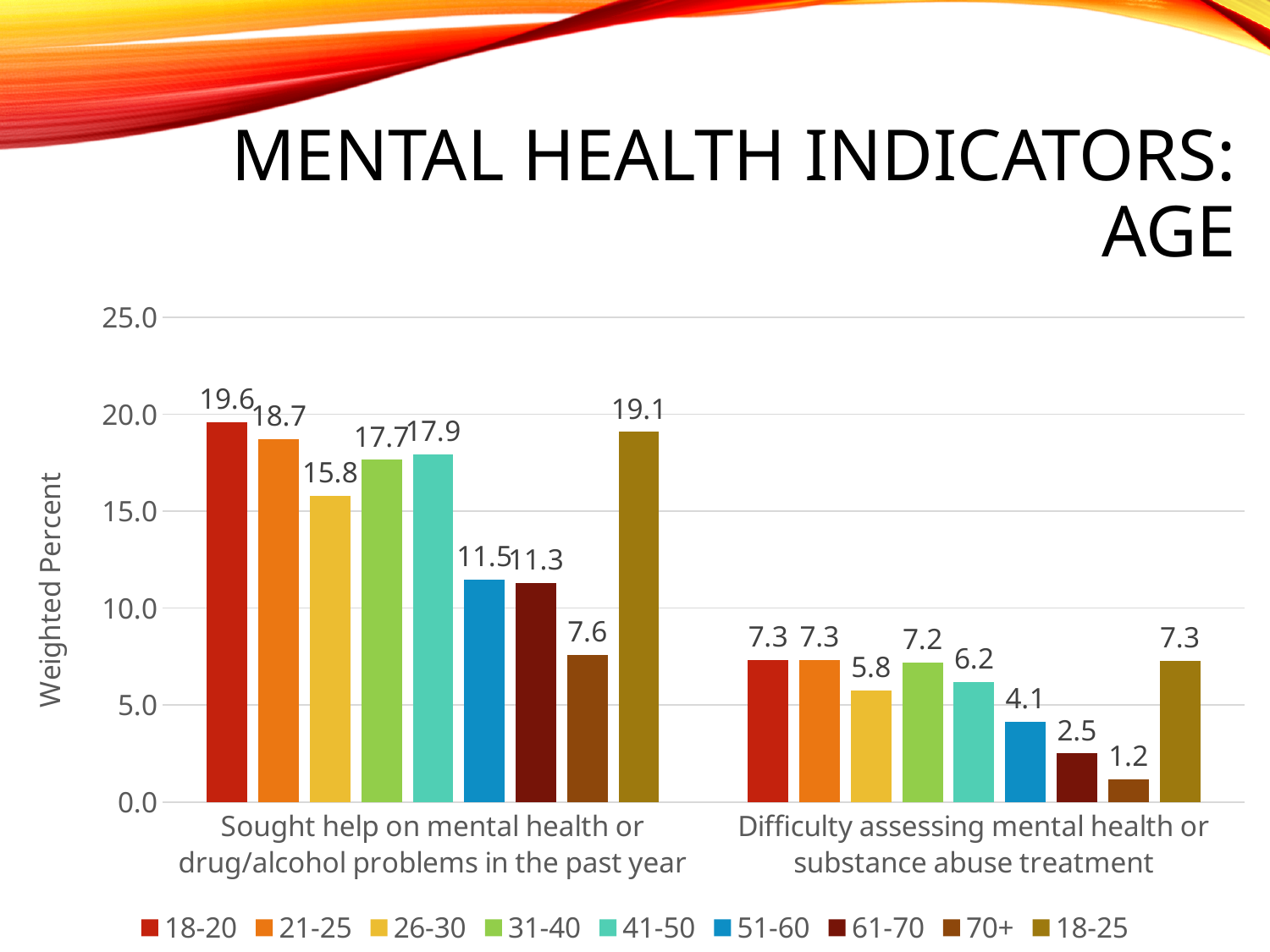
What is the value for the 51-60 age group for "Sought help on mental health or drug/alcohol problems in the past year"? 11.5 What is the label on the y axis? Weighted Percent What is the value for the 18-20 age group for "Sought help on mental health or drug/alcohol problems in the past year"? 19.6 For "Sought help on mental health or drug/alcohol problems in the past year", which is larger: the value for 26-30 or the value for 31-40? 31-40 What is the value for the 70+ age group for "Difficulty assessing mental health or substance abuse treatment"? 1.2 How many categories are shown on the x axis? 2 Which age group has the lowest value for "Difficulty assessing mental health or substance abuse treatment"? 70+ What is the difference between the 31-40 and 41-50 values for "Difficulty assessing mental health or substance abuse treatment"? 1.0 What kind of chart is shown on the slide? Bar chart Which age group has the highest value for "Sought help on mental health or drug/alcohol problems in the past year"? 18-20 What is the difference between the 18-20 and 70+ values for "Sought help on mental health or drug/alcohol problems in the past year"? 12.0 How many series does the legend list? 9